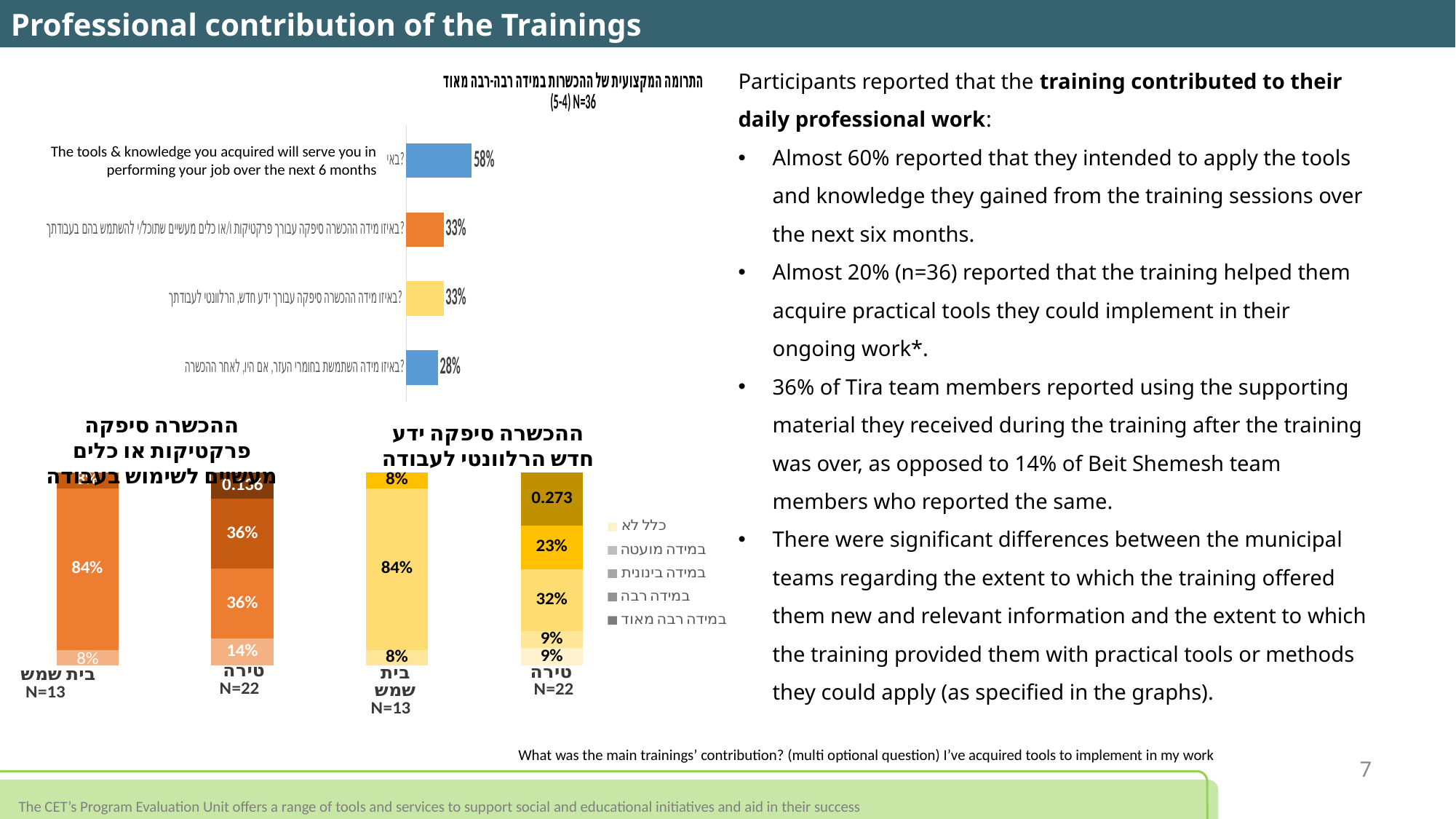
In the bottom-right stacked bar chart (yellow), what is the value of the top segment for טירה (N=22)? 0.273 How many entries does the legend next to the bottom stacked bar charts list? 5 In the top horizontal bar chart, what percentage is shown for 'The tools & knowledge you acquired will serve you in performing your job over the next 6 months'? 58% In the bottom-right stacked bar chart (yellow), what is the value of the 32% segment's neighbouring segment directly above it for טירה? 23% In the bottom-left stacked bar chart (orange), what is the largest segment value for בית שמש (N=13)? 84% In the top horizontal bar chart, which bar has the highest value? The tools & knowledge you acquired will serve you in performing your job over the next 6 months What type of chart is the top chart on the slide? Bar chart In the top horizontal bar chart, what is the value of the lowest (bottom) bar? 28% In the bottom-right stacked bar chart (yellow), which bar has the larger 84% segment: בית שמש or טירה? בית שמש In the bottom-left stacked bar chart (orange), what is the value of the bottom segment for טירה (N=22)? 14% In the top horizontal bar chart, how many bars are plotted? 4 In the top horizontal bar chart, what is the difference between the highest bar (58%) and the lowest bar (28%)? 30%